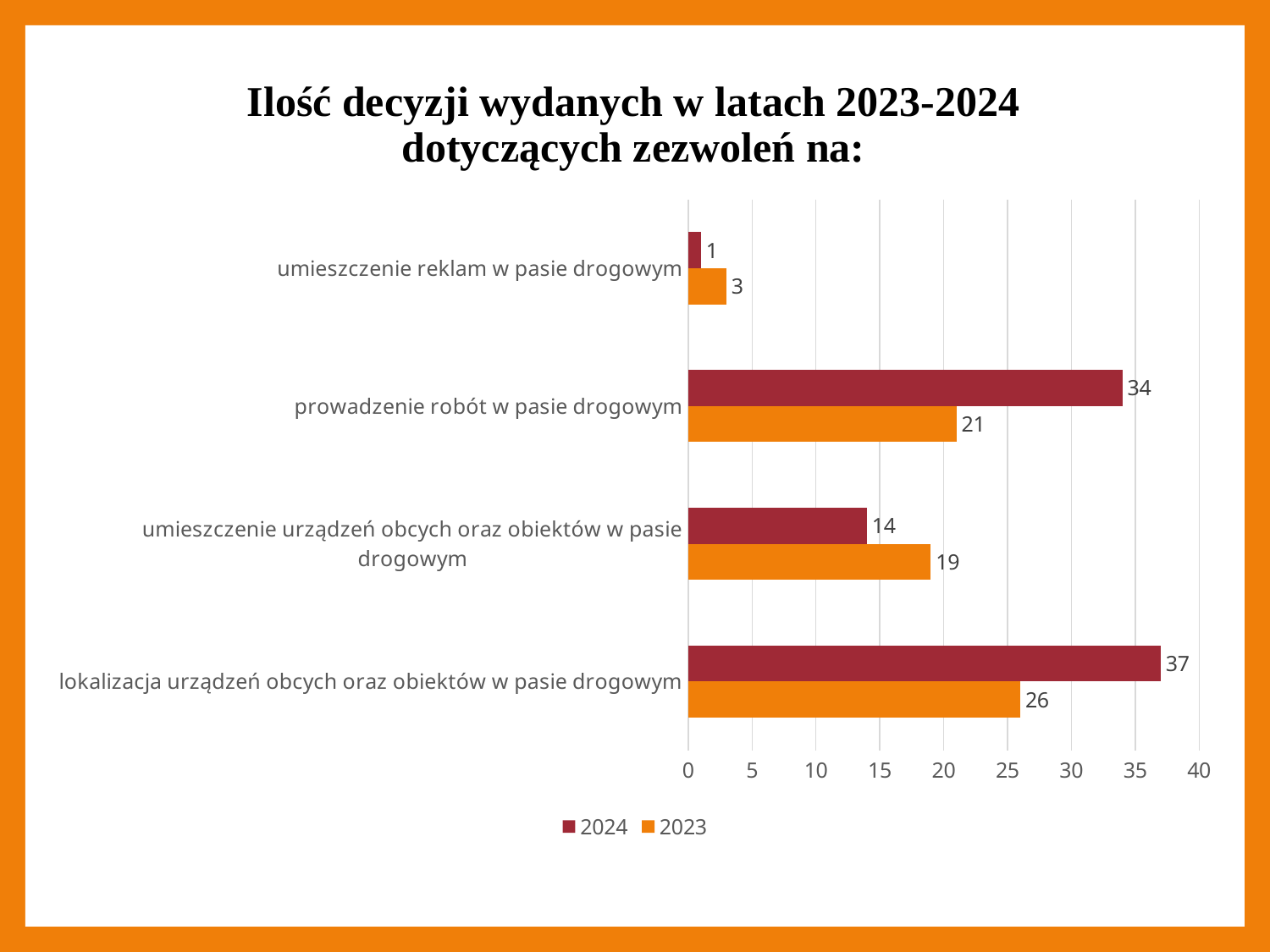
For "umieszczenie urządzeń obcych oraz obiektów w pasie drogowym", which year has the larger value, 2024 or 2023? 2023 Which category has the highest 2024 value? lokalizacja urządzeń obcych oraz obiektów w pasie drogowym What is the 2023 value for "lokalizacja urządzeń obcych oraz obiektów w pasie drogowym"? 26 How many series does the legend list? 2 What is the 2023 value for "umieszczenie reklam w pasie drogowym"? 3 What is the 2024 value for "prowadzenie robót w pasie drogowym"? 34 How many categories are shown on the chart? 4 Which category has the lowest 2023 value? umieszczenie reklam w pasie drogowym What is the difference between the 2024 and 2023 values for "prowadzenie robót w pasie drogowym"? 13 What is the difference between the 2024 and 2023 values for "lokalizacja urządzeń obcych oraz obiektów w pasie drogowym"? 11 Which series is shown in orange? 2023 What kind of chart is shown on the slide? bar chart